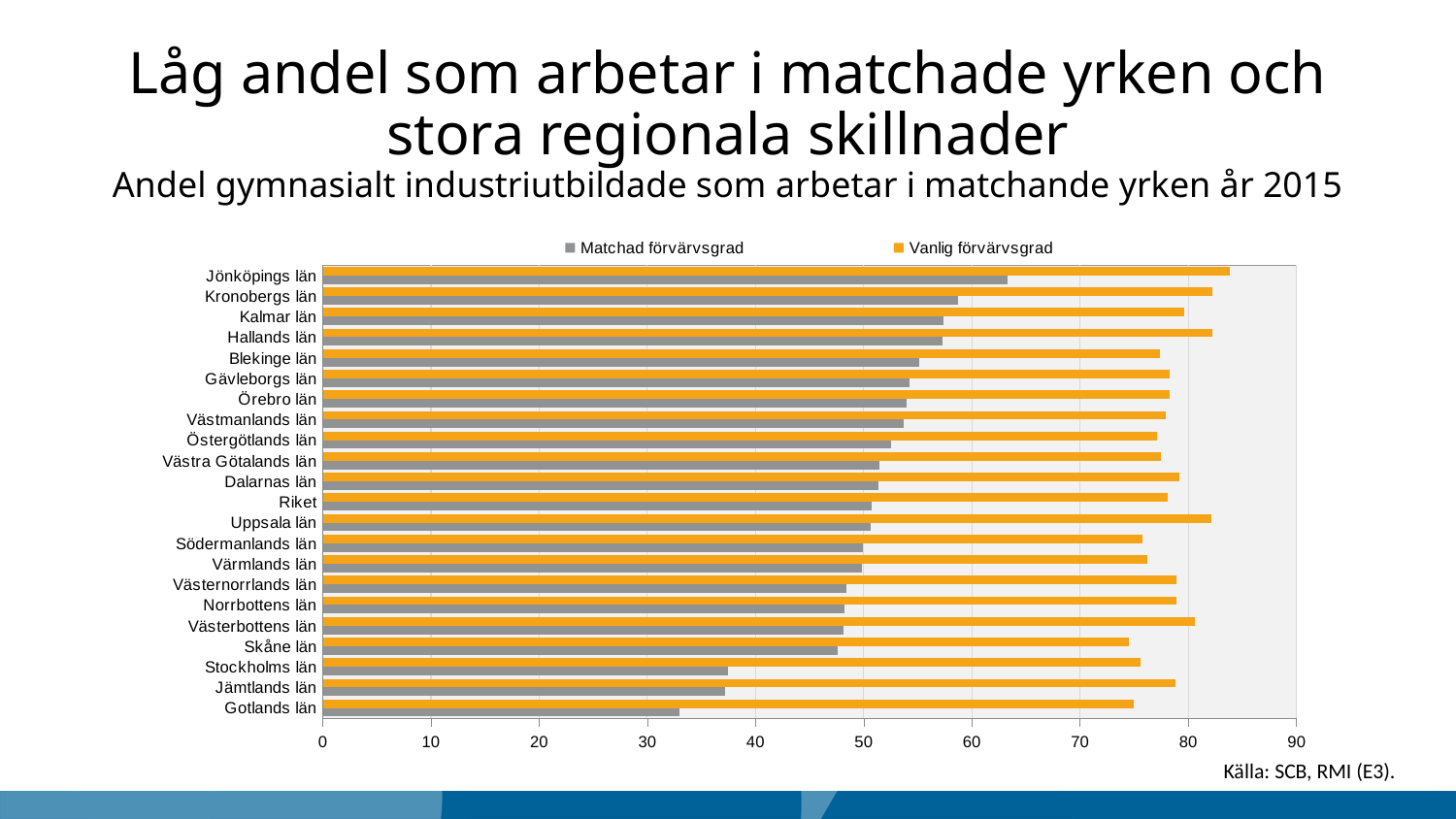
Is the Matchad förvärvsgrad value for Jönköpings län greater or less than 60? greater Which category has the highest value for Matchad förvärvsgrad? Jönköpings län Which is larger, the Matchad förvärvsgrad value for Kalmar län or for Gotlands län? Kalmar län Which category has the lowest value for Matchad förvärvsgrad? Gotlands län How many series does the legend list? 2 What kind of chart is shown on the slide? Bar chart Which series is shown in orange in the legend? Vanlig förvärvsgrad Is the Vanlig förvärvsgrad value for Skåne län greater or less than 80? less Do the Matchad förvärvsgrad values rise or fall going from the top category to the bottom category? fall Is the Vanlig förvärvsgrad value for Uppsala län greater or less than 80? greater How many categories (regions, including Riket) are shown on the vertical axis? 22